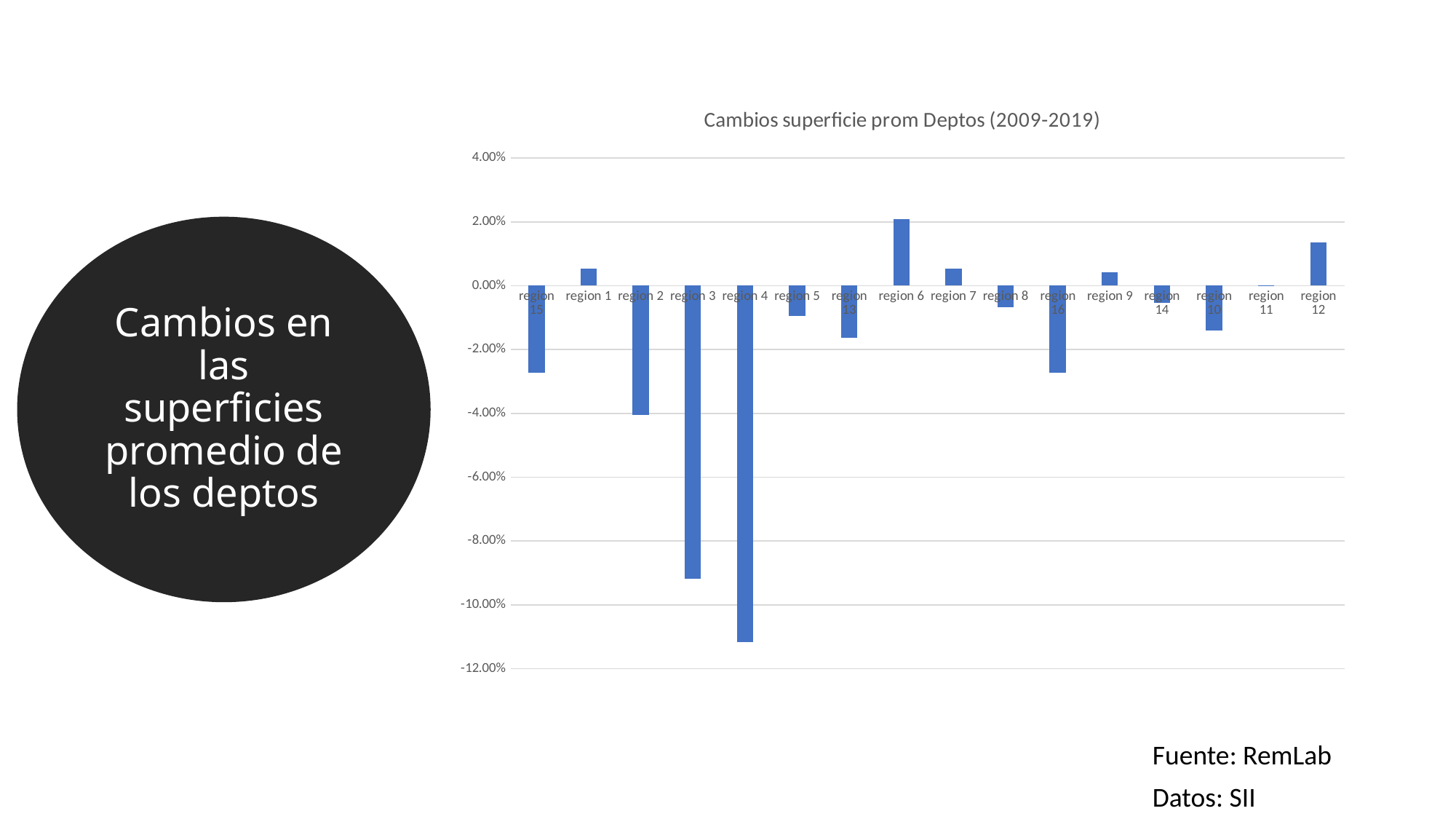
Which region has the highest value in the chart? region 6 How many regions (categories) are plotted in the chart? 16 Which has the lower value, region 2 or region 15? region 2 What kind of chart is shown on the slide? bar chart Is the value for region 4 greater or less than -10.00%? less Which region has the lowest value in the chart? region 4 Is the value for region 13 greater or less than -2.00%? greater Is the value for region 3 greater or less than -8.00%? less Which has the larger value, region 6 or region 12? region 6 What is the title of the chart? Cambios superficie prom Deptos (2009-2019)